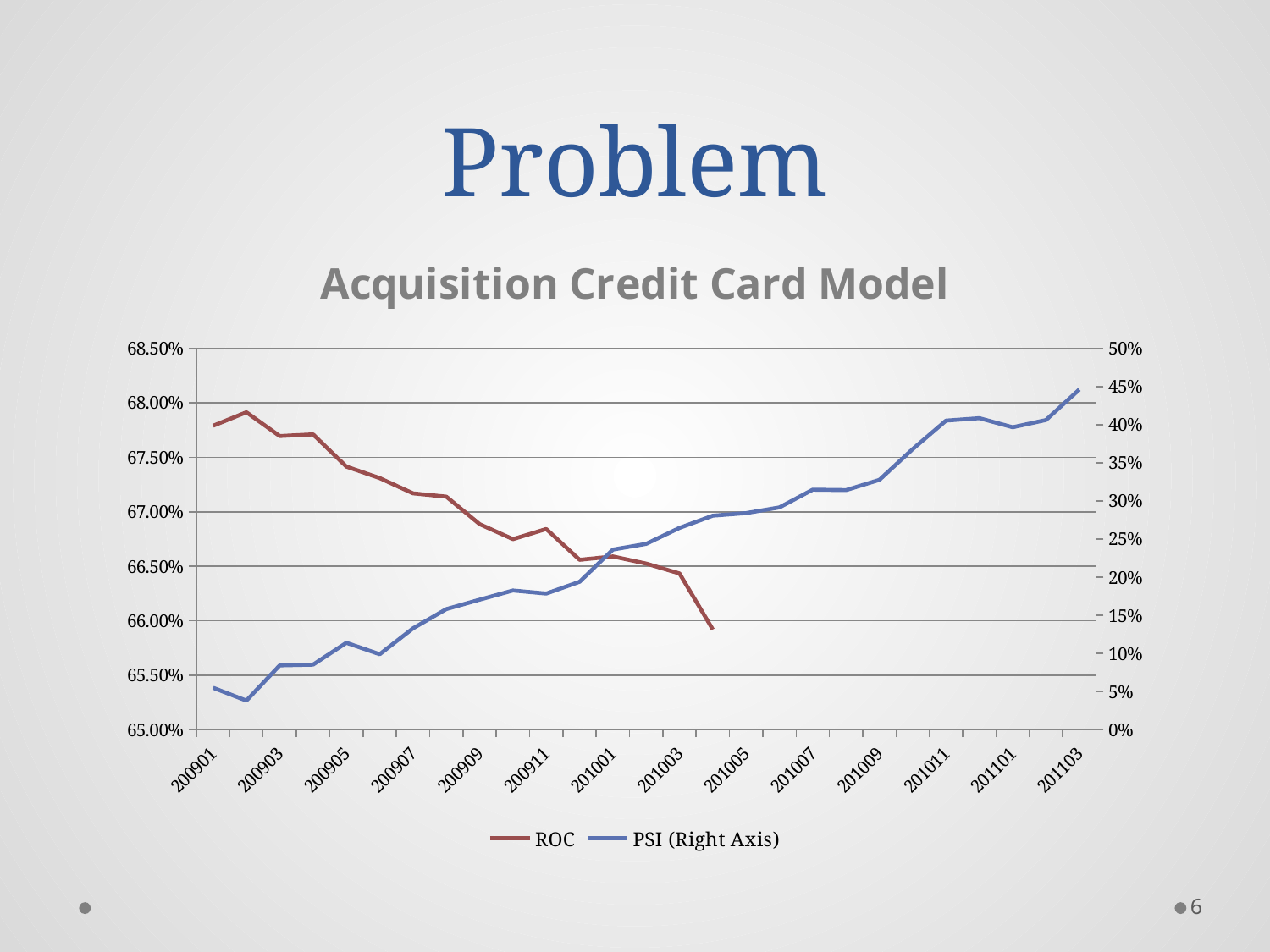
Is the ROC value at 200901 greater or less than 67.50%? greater Is the PSI value at 201103 greater or less than 40%? greater Which series is plotted against the right axis? PSI Is the ROC value at 200907 greater or less than 67.00%? greater How many series does the legend list? 2 What kind of chart is shown on the slide? Line chart Does the ROC series rise or fall from 200901 to its last point? Fall What is the title of the chart? Acquisition Credit Card Model Does the PSI series rise or fall from 200901 to 201103? Rise